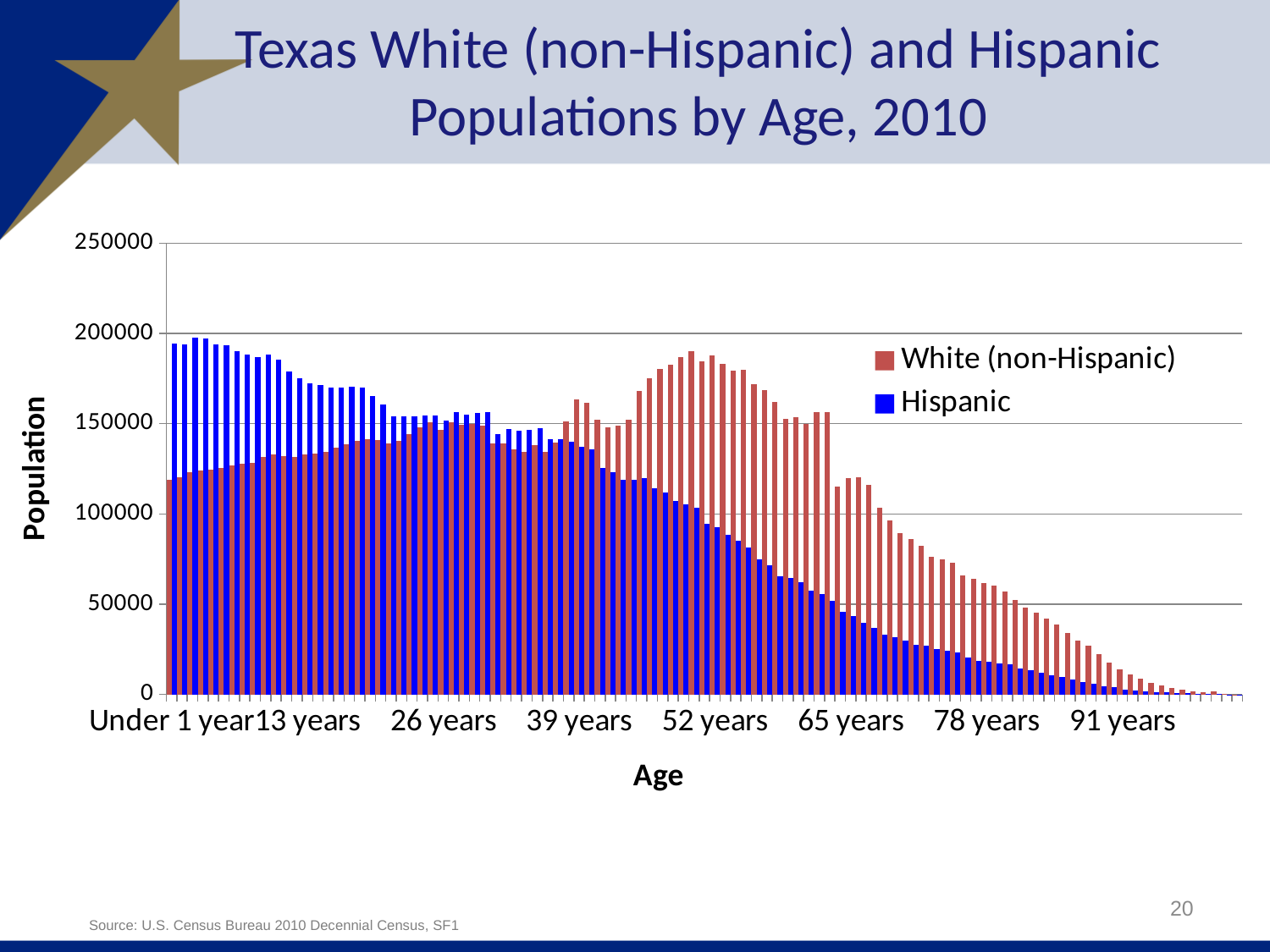
Is the White (non-Hispanic) value for Under 1 year greater or less than 150000? less Is the Hispanic value for Under 1 year greater or less than 150000? greater At 52 years, which series has the larger value, White (non-Hispanic) or Hispanic? White (non-Hispanic) How many series does the legend list? 2 Is the White (non-Hispanic) value for 52 years greater or less than 150000? greater Do the Hispanic values generally rise or fall from 39 years to 91 years? Fall What is the title of the chart? Texas White (non-Hispanic) and Hispanic Populations by Age, 2010 Which colour represents the Hispanic series in the chart? Blue At Under 1 year, which series has the larger value, White (non-Hispanic) or Hispanic? Hispanic What kind of chart is shown on the slide? Bar chart